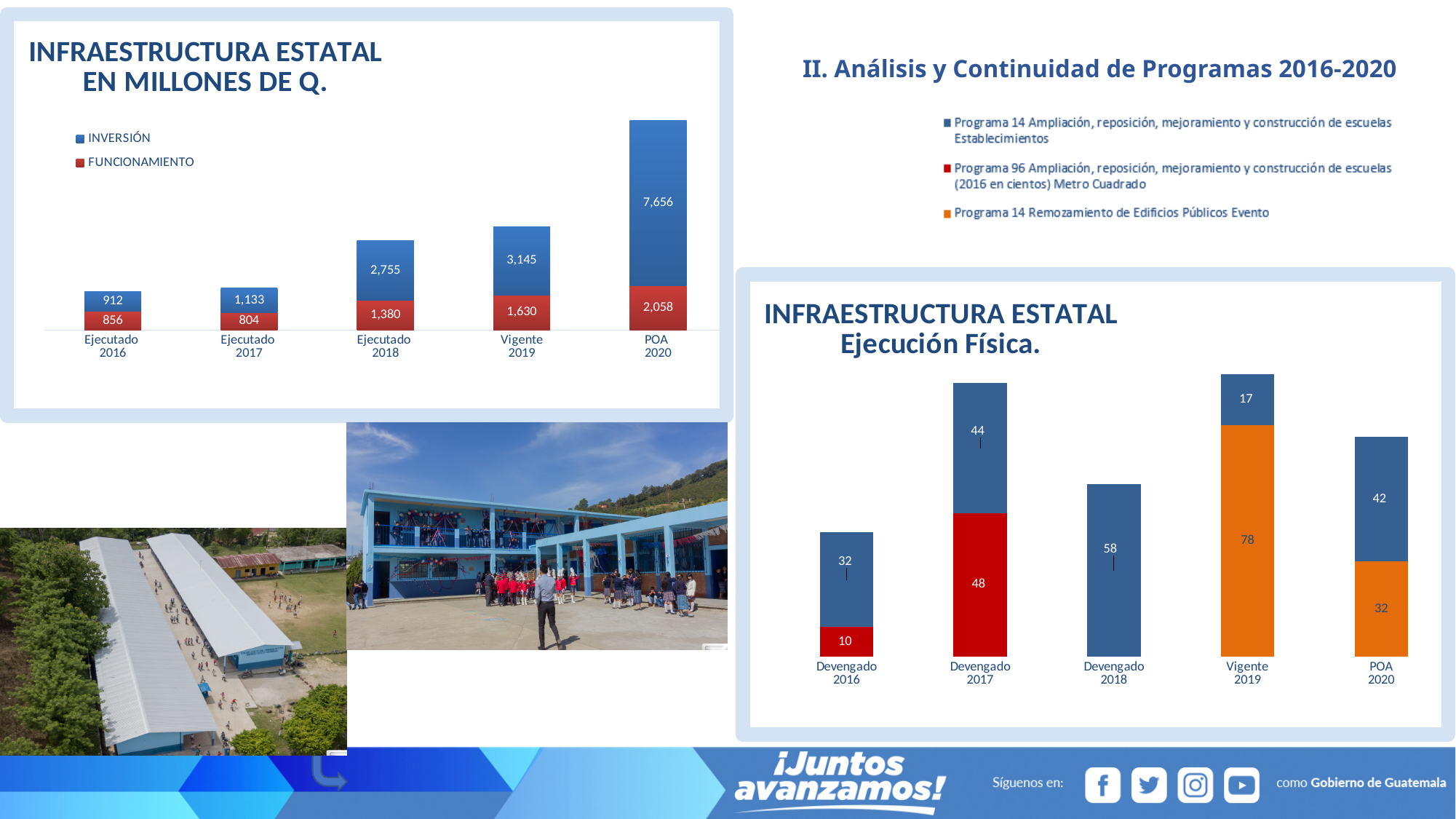
In the 'INFRAESTRUCTURA ESTATAL EN MILLONES DE Q.' chart, what is the INVERSIÓN value for POA 2020? 7,656 In the 'INFRAESTRUCTURA ESTATAL Ejecución Física.' chart, what is the total of the stacked bar for Devengado 2017? 92 In the 'INFRAESTRUCTURA ESTATAL EN MILLONES DE Q.' chart, does the INVERSIÓN value rise or fall from Ejecutado 2016 to POA 2020? rise In the 'INFRAESTRUCTURA ESTATAL EN MILLONES DE Q.' chart, which category has the highest INVERSIÓN value? POA 2020 In the 'INFRAESTRUCTURA ESTATAL EN MILLONES DE Q.' chart, how many series does the legend list? 2 In the 'INFRAESTRUCTURA ESTATAL Ejecución Física.' chart, how many categories are shown on the x axis? 5 In the 'INFRAESTRUCTURA ESTATAL Ejecución Física.' chart, what is the value of the orange segment for Vigente 2019? 78 In the 'INFRAESTRUCTURA ESTATAL EN MILLONES DE Q.' chart, what is the FUNCIONAMIENTO value for Ejecutado 2018? 1,380 In the 'INFRAESTRUCTURA ESTATAL EN MILLONES DE Q.' chart, what is the total of the stacked bar for Ejecutado 2016? 1,768 In the 'INFRAESTRUCTURA ESTATAL EN MILLONES DE Q.' chart, what is the difference between the INVERSIÓN values for Vigente 2019 and Ejecutado 2018? 390 In the 'INFRAESTRUCTURA ESTATAL EN MILLONES DE Q.' chart, which category has the lowest FUNCIONAMIENTO value? Ejecutado 2017 What kind of chart is the 'INFRAESTRUCTURA ESTATAL Ejecución Física.' chart? stacked bar chart